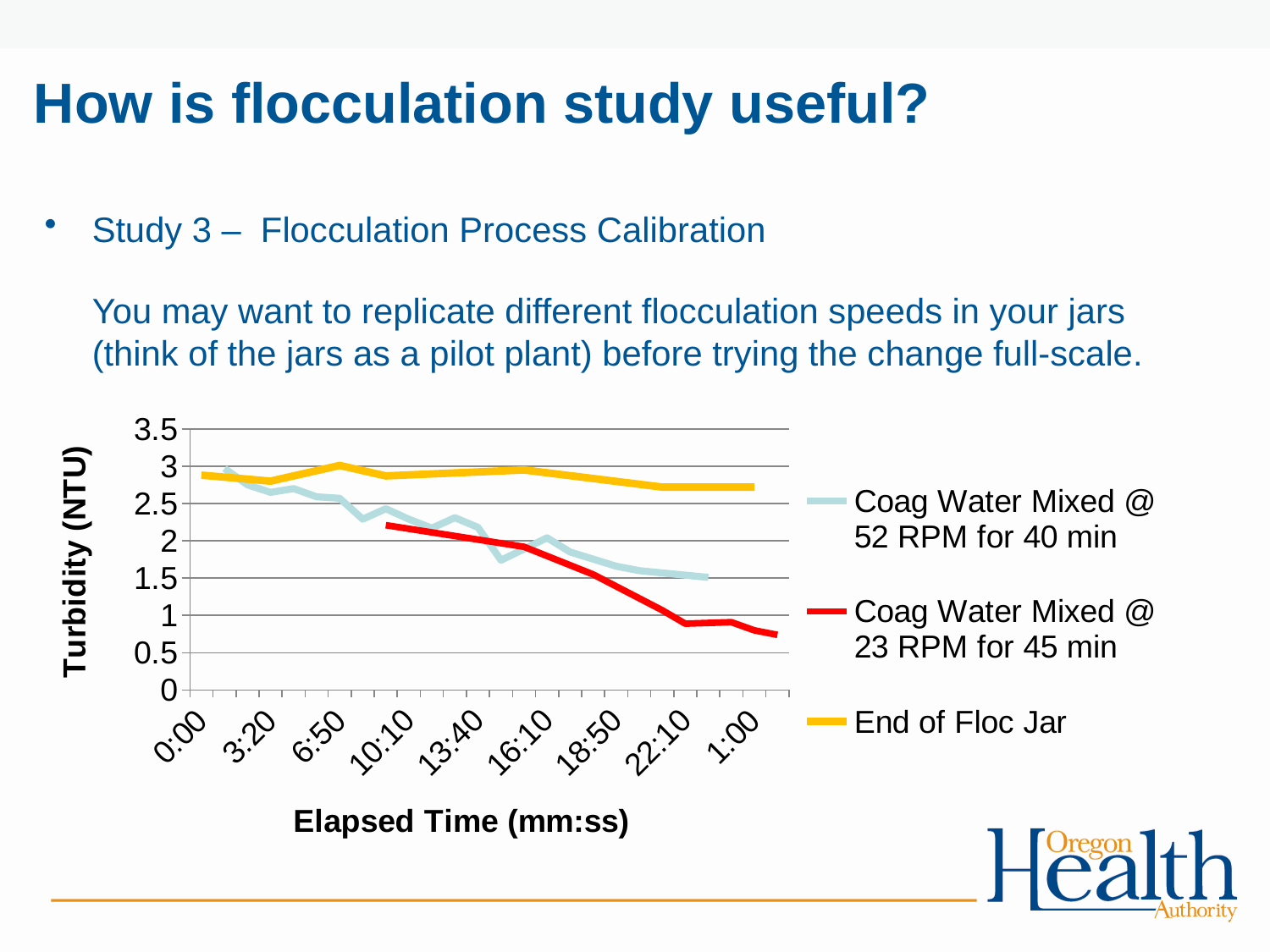
At 1:00, which series has the higher turbidity: 'End of Floc Jar' or 'Coag Water Mixed @ 23 RPM for 45 min'? End of Floc Jar What is the title of the vertical axis? Turbidity (NTU) What kind of chart is shown on the slide? line chart Which series has the highest turbidity at 22:10? End of Floc Jar Is the turbidity for 'Coag Water Mixed @ 23 RPM for 45 min' at 1:00 greater or less than 1? less Does the turbidity for 'Coag Water Mixed @ 52 RPM for 40 min' rise or fall as elapsed time increases? fall How many series does the legend list? 3 Is the turbidity for 'End of Floc Jar' at 0:00 greater or less than 2.5? greater How many labelled tick marks are shown on the Elapsed Time axis? 9 Does the turbidity for 'Coag Water Mixed @ 23 RPM for 45 min' rise or fall as elapsed time increases? fall At 18:50, which series has the higher turbidity: 'Coag Water Mixed @ 52 RPM for 40 min' or 'Coag Water Mixed @ 23 RPM for 45 min'? Coag Water Mixed @ 52 RPM for 40 min